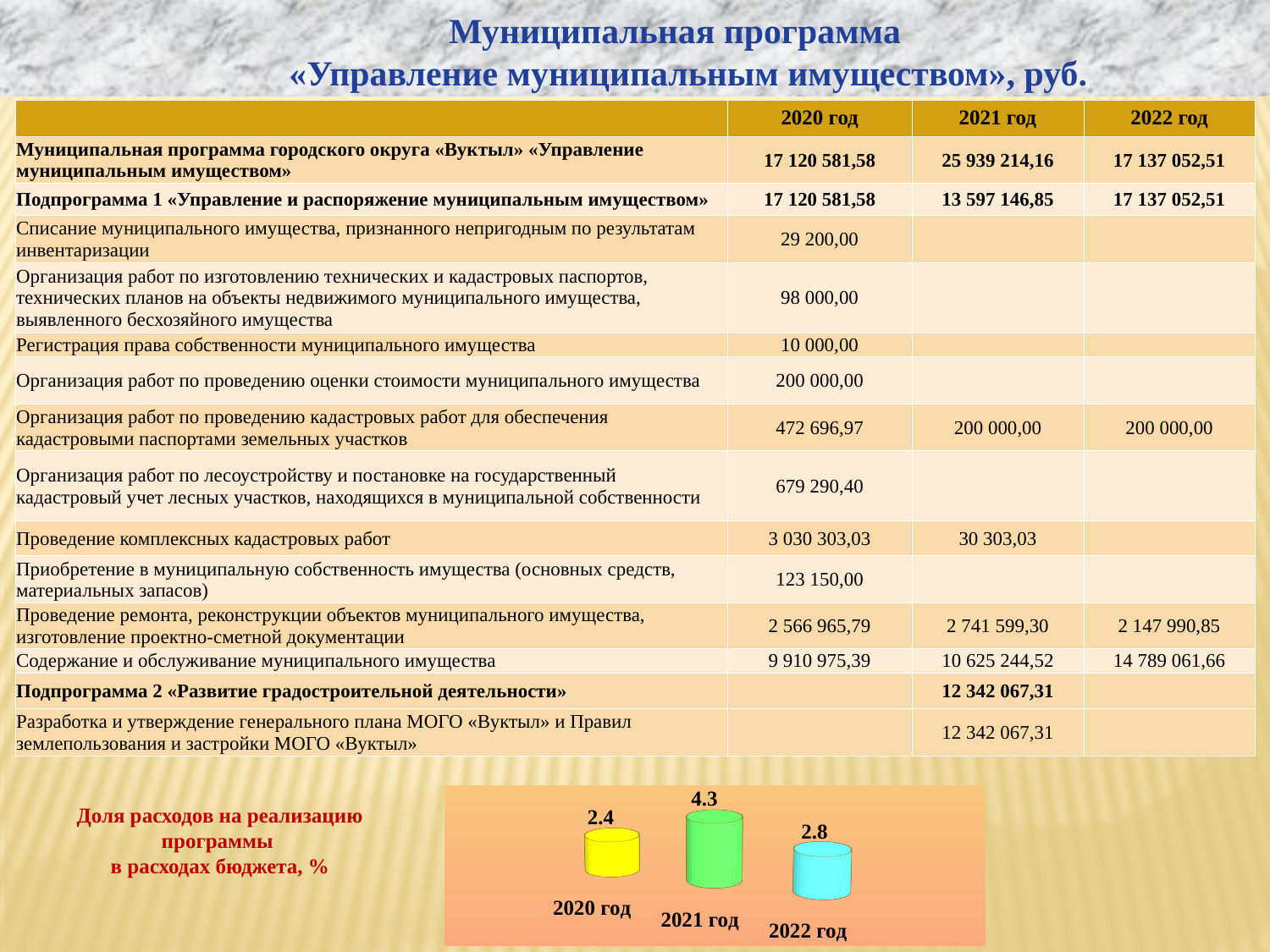
How many years (categories) are plotted in the chart at the bottom of the slide? 3 What is the value shown for 2022 год in the chart at the bottom of the slide? 2.8 What kind of chart is shown at the bottom of the slide? Bar chart Which year has the lowest value in the chart at the bottom of the slide? 2020 год In the chart at the bottom of the slide, does the value rise or fall from 2021 год to 2022 год? Fall In the chart at the bottom of the slide, what is the difference between the values for 2021 год and 2020 год? 1.9 What is the value shown for 2021 год in the chart at the bottom of the slide? 4.3 What is the value shown for 2020 год in the chart at the bottom of the slide? 2.4 What colour is the bar for 2021 год in the chart at the bottom of the slide? Green In the chart at the bottom of the slide, what is the difference between the values for 2022 год and 2020 год? 0.4 In the chart at the bottom of the slide, which is larger: the value for 2022 год or the value for 2020 год? 2022 год Which year has the highest value in the chart at the bottom of the slide? 2021 год